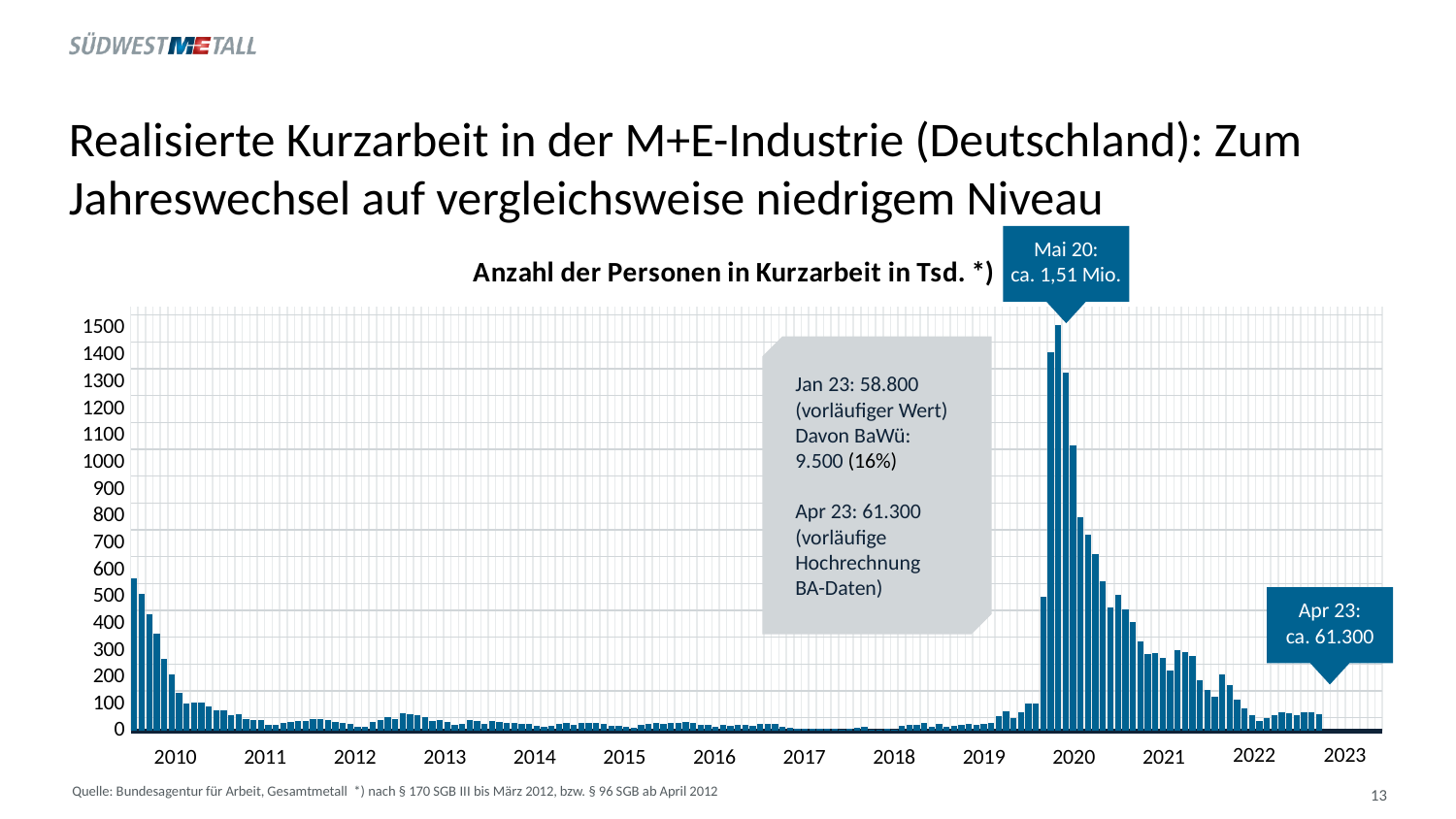
What kind of chart is shown on the slide? bar chart What is the value given for Jan 23? 58.800 What is the difference between the Apr 23 value and the Jan 23 value? 2.500 Which is larger, the value for Jan 23 or the value for Apr 23? Apr 23 Is the value for the peak in 2020 greater or less than 1400? greater In which month and year does the chart reach its highest value? Mai 20 Do the values rise or fall over the course of 2010? fall What share of the Jan 23 value comes from BaWü? 16% How many persons in Kurzarbeit in Jan 23 are from BaWü? 9.500 What is the value given for Apr 23? 61.300 What value does the callout give for Mai 20? ca. 1,51 Mio. What is the title of the chart? Anzahl der Personen in Kurzarbeit in Tsd. *)